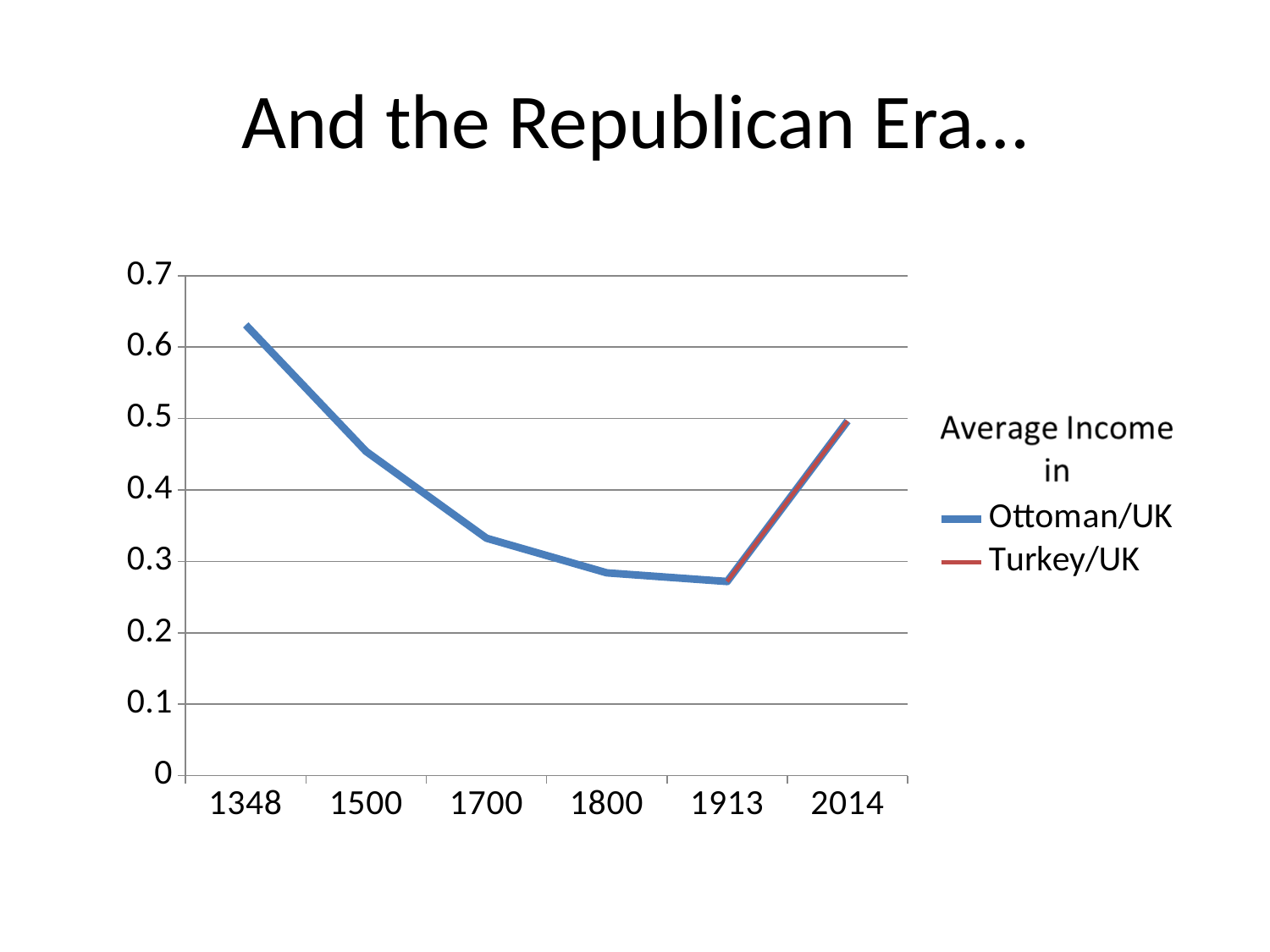
What kind of chart is shown on the slide? line chart Is the Ottoman/UK value for 1500 greater or less than 0.4? greater Is the value for 2014 greater or less than 0.4? greater Is the Ottoman/UK value for 1913 greater or less than 0.3? less How many series does the legend list? 2 How many years are labelled on the x axis? 6 What colour is the Turkey/UK line in the legend? red Which is larger, the value for 1348 or the value for 2014? 1348 Which year has the highest value for Ottoman/UK? 1348 Does the Ottoman/UK line rise or fall from 1348 to 1913? fall Does the line rise or fall from 1913 to 2014? rise